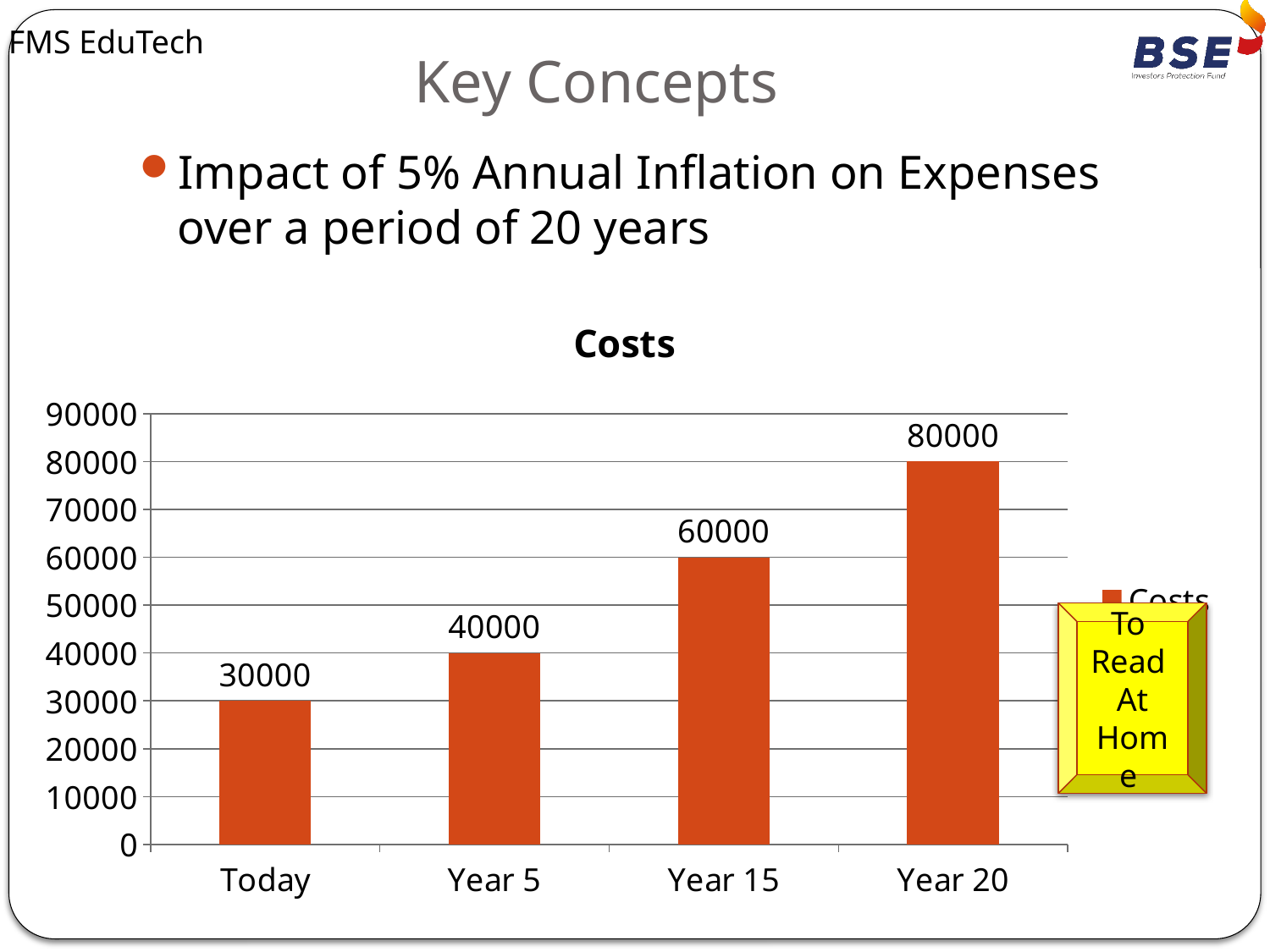
What kind of chart is shown? bar chart How many categories are shown on the x axis? 4 What is the value for Year 15? 60000 Which is larger, the value for Year 5 or the value for Year 15? Year 15 What is the value for Year 20? 80000 What is the difference between the values for Year 15 and Year 5? 20000 Do the values rise or fall from Today to Year 20? rise Which category has the highest value? Year 20 What is the value for Today? 30000 Which category has the lowest value? Today What is the difference between the values for Year 20 and Today? 50000 What is the value for Year 5? 40000